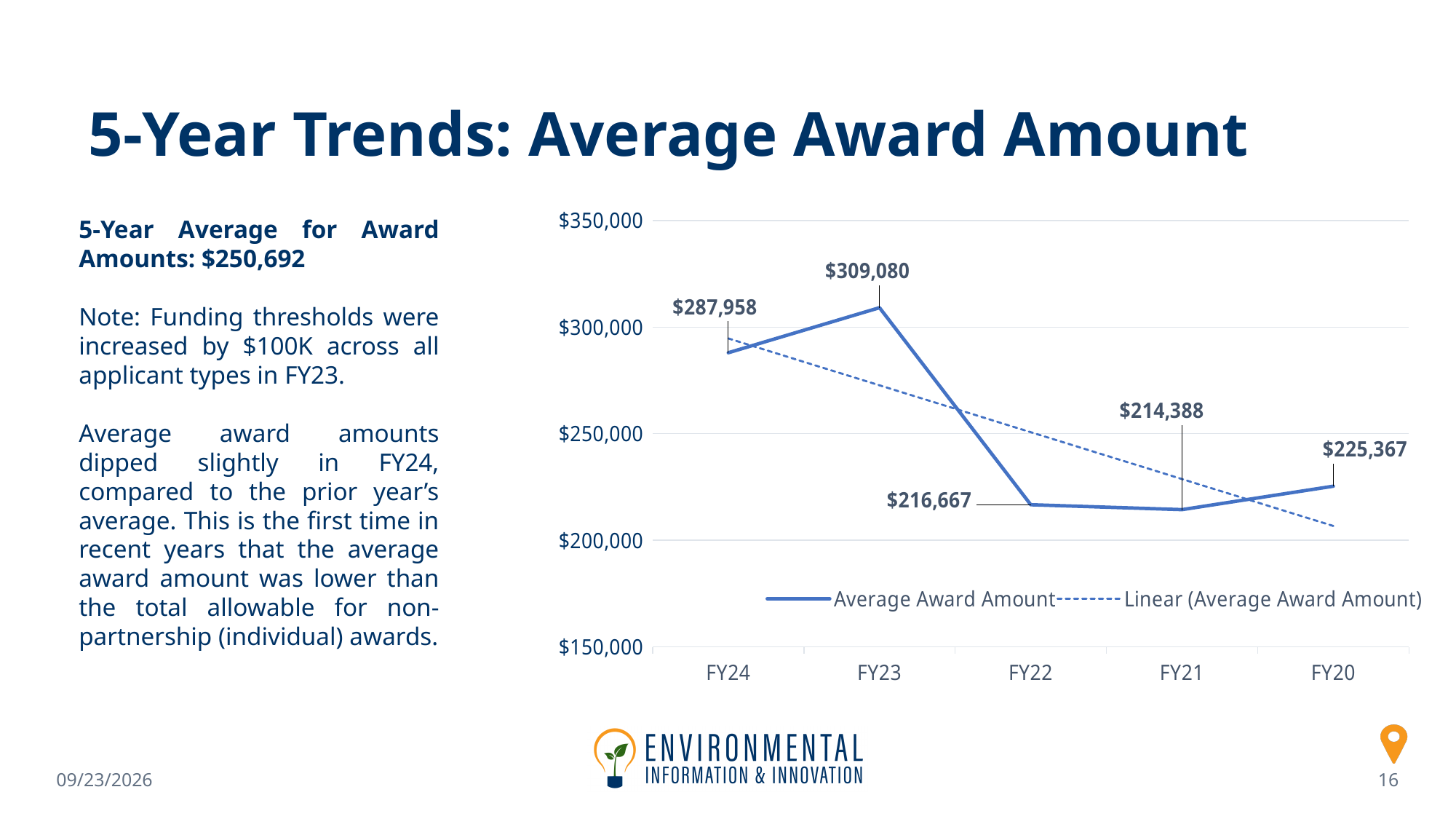
What is the average award amount for FY21? $214,388 What is the average award amount for FY20? $225,367 Which fiscal year has the lowest average award amount? FY21 Which fiscal year has the highest average award amount? FY23 Is the average award amount for FY22 greater or less than $250,000? less What kind of chart is shown on the slide? line chart What is the difference between the average award amounts for FY20 and FY21? $10,979 What is the average award amount for FY23? $309,080 What is the difference between the average award amounts for FY23 and FY24? $21,122 Which has a larger average award amount, FY24 or FY20? FY24 How many entries does the chart legend list? 2 How many fiscal years are plotted on the chart? 5